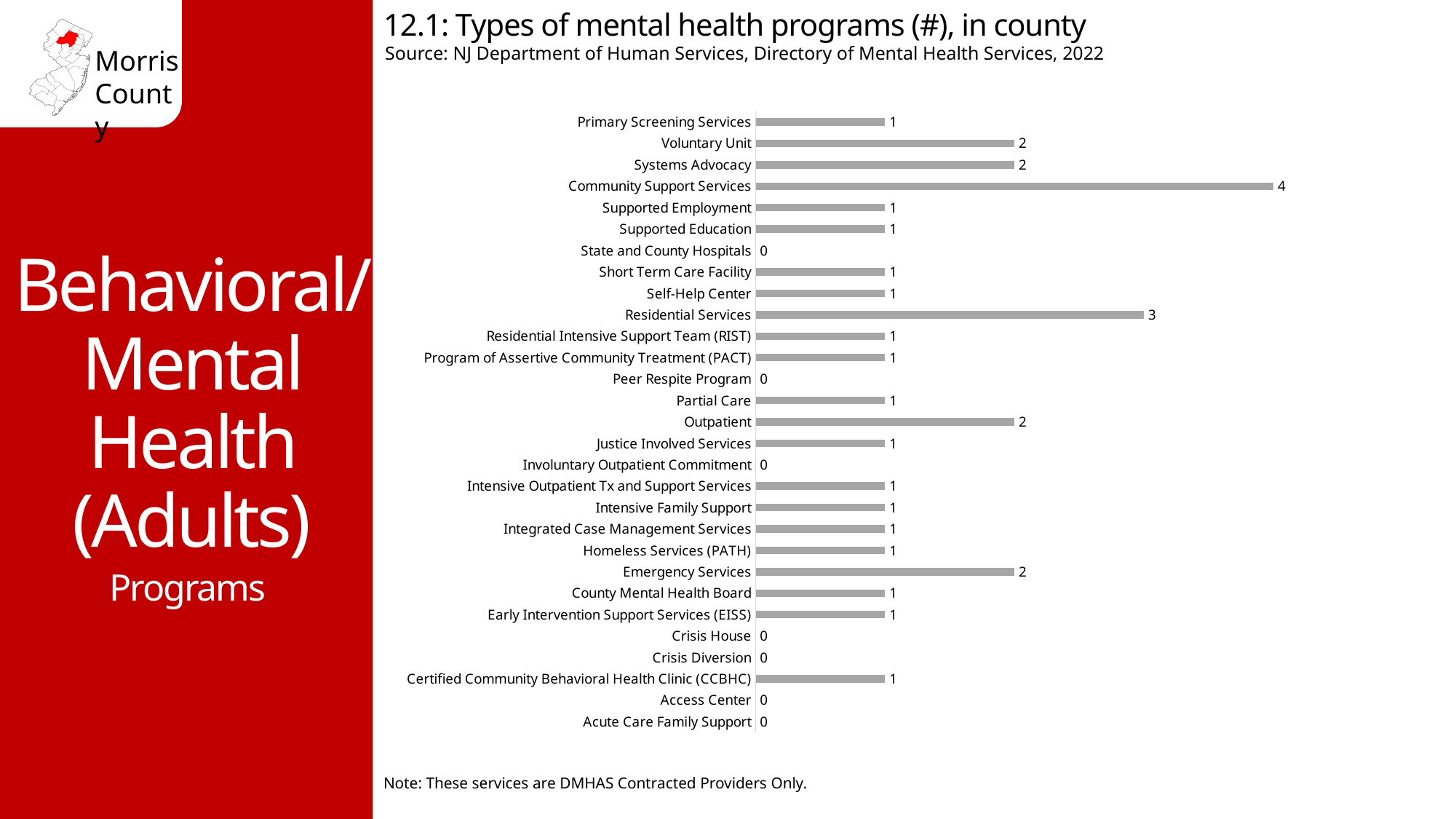
What is the value for Community Support Services? 4 What is the difference between Community Support Services and Residential Services? 1 What is the value for Emergency Services? 2 What is the value for Crisis House? 0 What kind of chart is this? Bar chart What is the title of the chart? 12.1: Types of mental health programs (#), in county Which is larger, Outpatient or Partial Care? Outpatient Which category has the highest value? Community Support Services What is the source cited for the chart? NJ Department of Human Services, Directory of Mental Health Services, 2022 What is the value for Residential Services? 3 How many categories have a value of 0? 7 How many categories are shown in the chart? 29